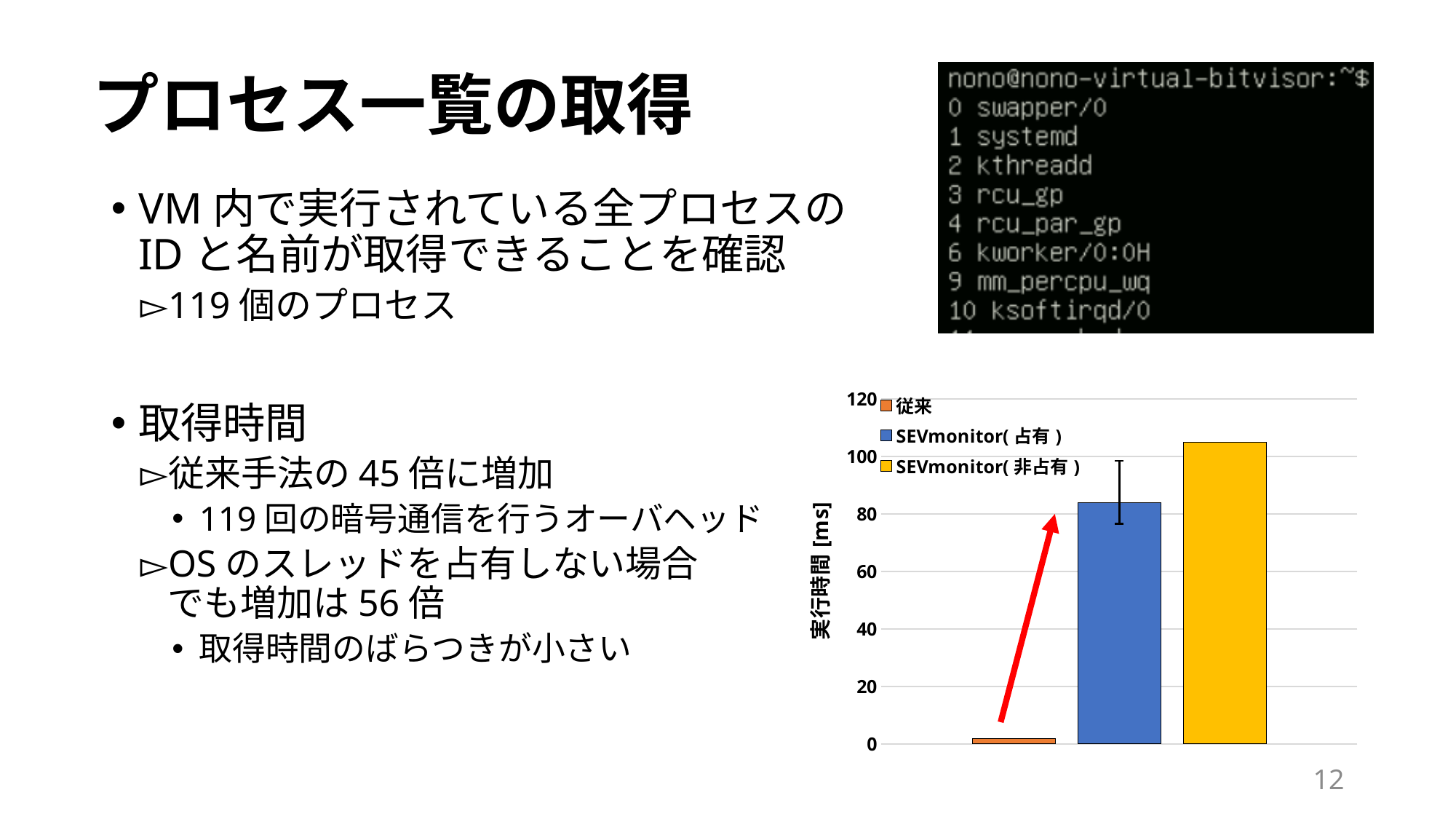
Is the value for SEVmonitor(非占有) greater or less than 100? greater Is the value for SEVmonitor(占有) greater or less than 100? less Which series has the highest execution time in the chart? SEVmonitor(非占有) What is the label of the vertical axis of the chart? 実行時間 [ms] How many bars are plotted in the chart? 3 Which is larger, the value for 従来 or the value for SEVmonitor(占有)? SEVmonitor(占有) Is the value for 従来 greater or less than 20? less How many series does the chart legend list? 3 Which series has the lowest execution time in the chart? 従来 What kind of chart is shown on the slide? bar chart What colour is the bar for SEVmonitor(占有)? blue Which is larger, the value for SEVmonitor(占有) or the value for SEVmonitor(非占有)? SEVmonitor(非占有)